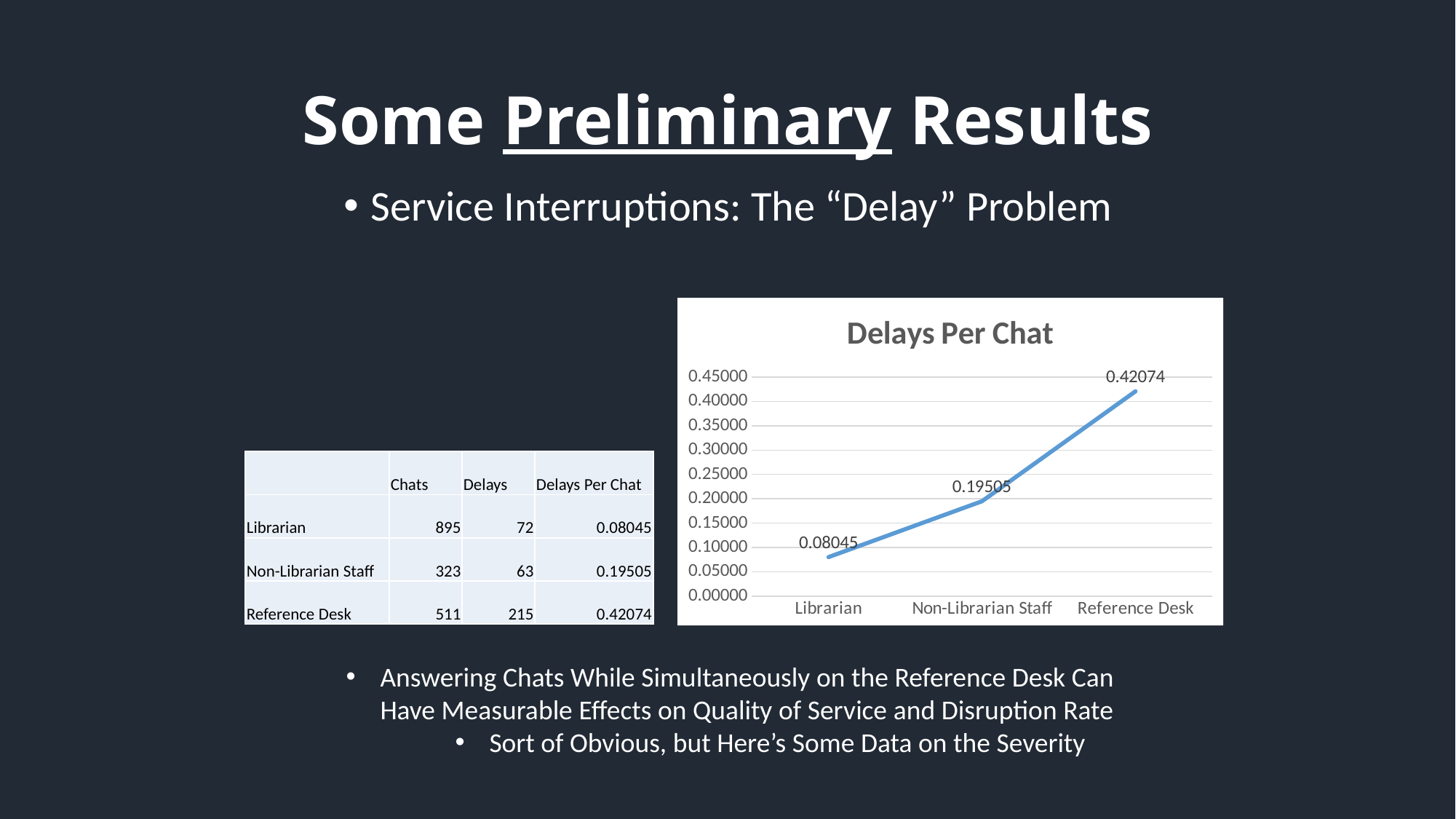
Do the values rise or fall from Librarian to Reference Desk along the x axis? rise What is the difference in Delays Per Chat between Reference Desk and Librarian? 0.34029 What is the Delays Per Chat value for Non-Librarian Staff? 0.19505 Is the Delays Per Chat value for Non-Librarian Staff greater or less than 0.25000? less What is the difference in Delays Per Chat between Non-Librarian Staff and Librarian? 0.11460 Which category has the lowest Delays Per Chat value? Librarian What is the Delays Per Chat value for Reference Desk? 0.42074 How many categories are plotted on the x axis of the chart? 3 Which category has the highest Delays Per Chat value? Reference Desk What kind of chart is shown on the slide? line chart What is the Delays Per Chat value for Librarian? 0.08045 Which has a higher Delays Per Chat value, Non-Librarian Staff or Reference Desk? Reference Desk